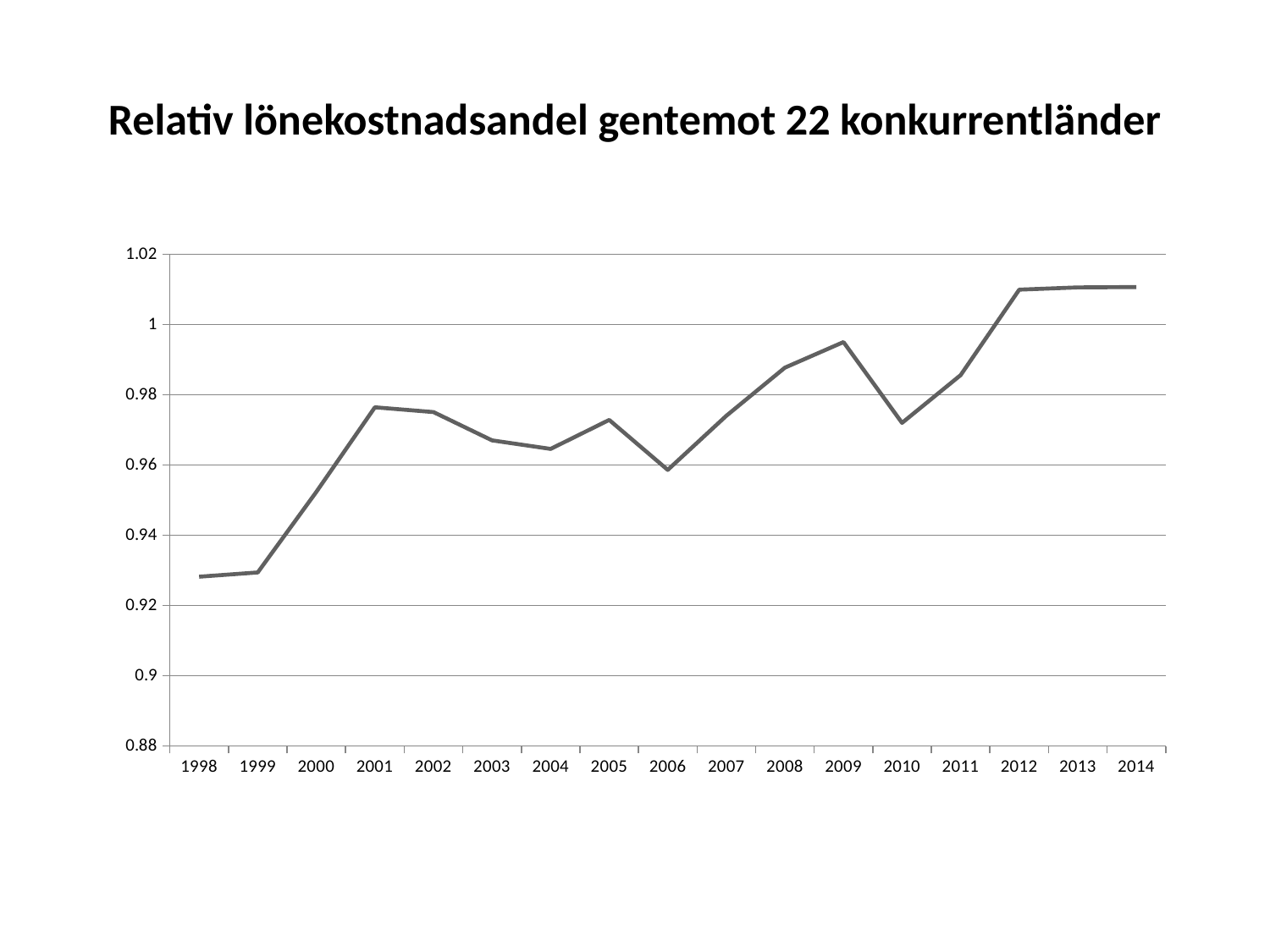
What is the title of the chart? Relativ lönekostnadsandel gentemot 22 konkurrentländer How many years are plotted along the x axis? 17 Is the value for 2009 greater or less than 0.98? greater Is the value for 2012 greater or less than 1? greater Which year has the larger value, 2006 or 2008? 2008 Is the value for 2001 greater or less than 0.96? greater What kind of chart is shown on the slide? line chart Which year has the larger value, 2009 or 2010? 2009 Which year has the lowest value on the chart? 1998 Overall, does the line rise or fall from 1998 to 2014? rise